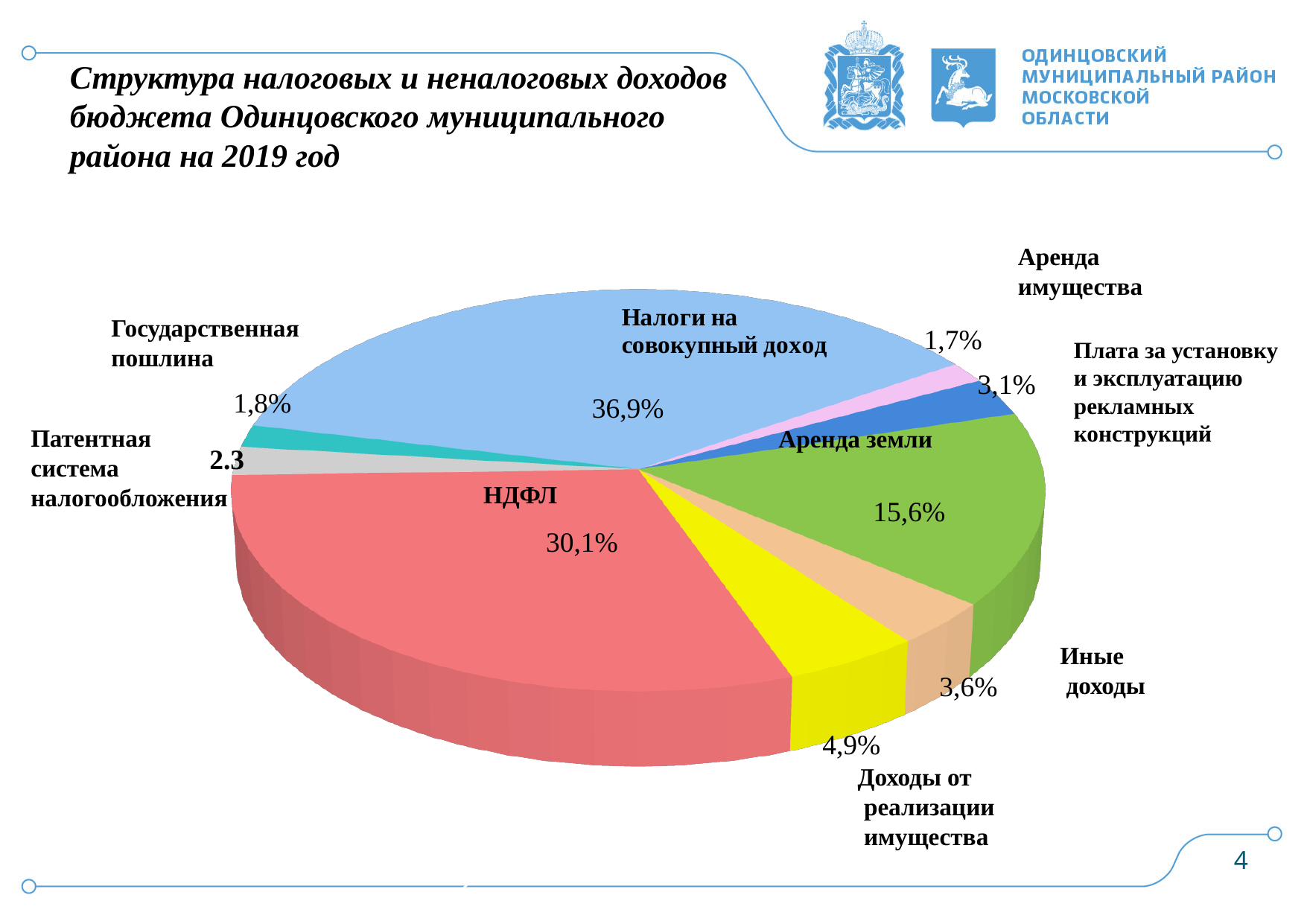
What share of the pie does НДФЛ have? 30,1% What is the value shown for Патентная система налогообложения? 2.3 What is the value shown for Плата за установку и эксплуатацию рекламных конструкций? 3,1% What colour is the slice for Аренда земли? green What is the difference between the shares of Налоги на совокупный доход and НДФЛ? 6,8% Which category has the smallest share of the pie? Аренда имущества Which category has the largest share of the pie? Налоги на совокупный доход How many slices does the pie chart have? 9 Which is larger, the share of Иные доходы or the share of Доходы от реализации имущества? Доходы от реализации имущества What is the value shown for Аренда земли? 15,6% What is the value shown for Доходы от реализации имущества? 4,9% What kind of chart is shown on the slide? pie chart